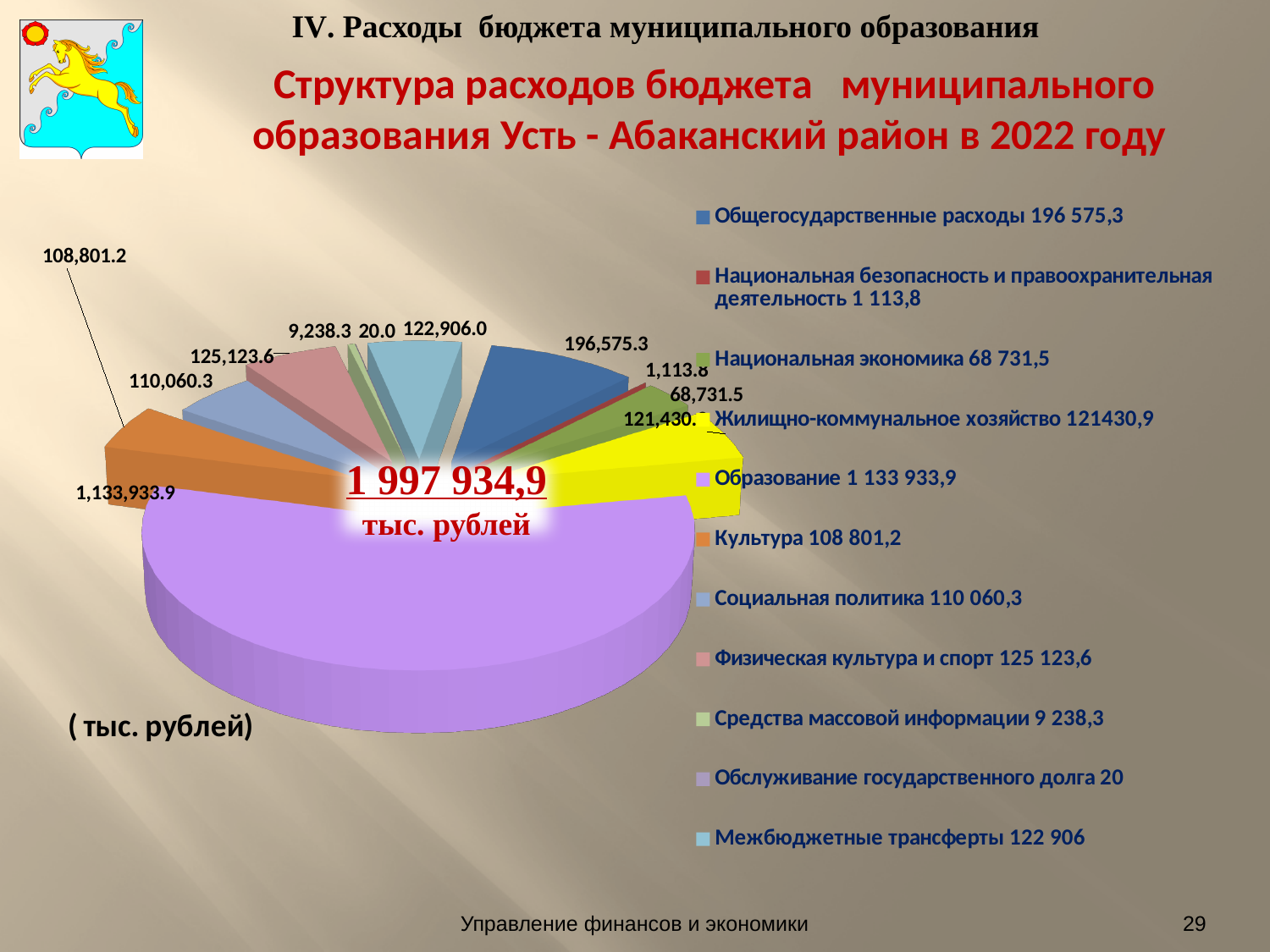
In what units are the values of the chart given, according to the label at the bottom left of the chart? тыс. рублей Which category has the largest slice of the pie? Образование Which is larger, the value for Культура or the value for Социальная политика? Социальная политика What is the value shown on the chart for Образование? 1,133,933.9 What is the value shown on the chart for Общегосударственные расходы? 196,575.3 What total amount is printed in the centre of the pie chart? 1 997 934,9 тыс. рублей How many categories (slices) does the pie chart have? 11 What is the value shown on the chart for Физическая культура и спорт? 125,123.6 What is the difference between the values for Общегосударственные расходы and Межбюджетные трансферты? 73,669.3 Which category has the smallest value in the pie chart? Обслуживание государственного долга What is the value shown on the chart for Средства массовой информации? 9,238.3 What kind of chart is shown on the slide? pie chart